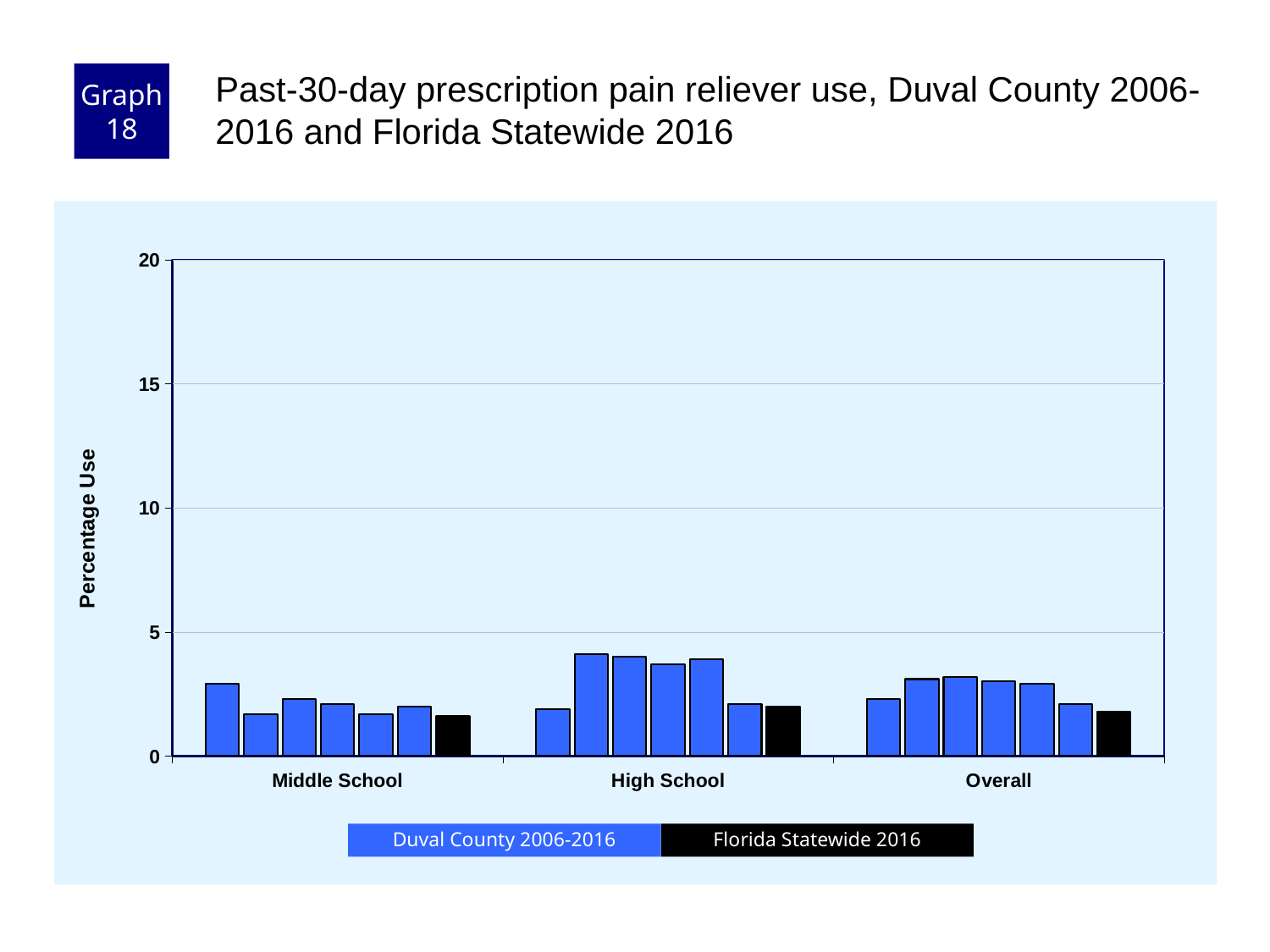
How many categories are shown on the x axis? 3 Is the value for Florida Statewide 2016 in the Middle School category greater or less than 5? less What is the label on the y axis? Percentage Use What kind of chart is shown on the slide? bar chart Which category has the shortest Duval County 2006-2016 bars overall? Middle School Which category has the tallest Duval County 2006-2016 bar? High School In the High School category, which is larger: the tallest Duval County 2006-2016 bar or the Florida Statewide 2016 bar? the tallest Duval County 2006-2016 bar Which is larger: the tallest Duval County 2006-2016 bar for High School or the tallest Duval County 2006-2016 bar for Middle School? High School Is the value for Florida Statewide 2016 in the High School category greater or less than 5? less What are the two series listed in the legend? Duval County 2006-2016 and Florida Statewide 2016 How many series does the legend list? 2 Is the tallest Duval County 2006-2016 bar in the High School category greater or less than 5? less